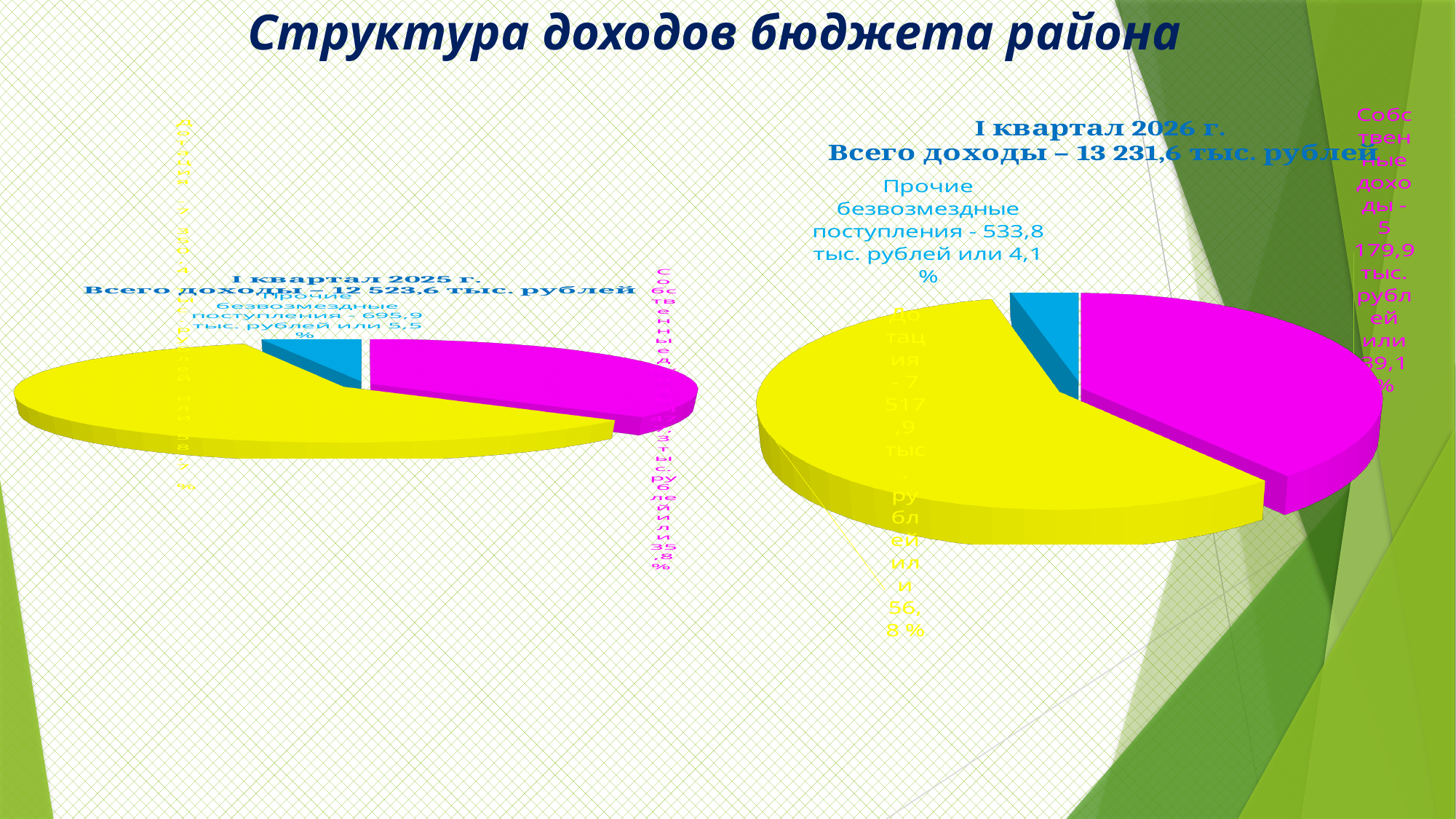
In the 'I квартал 2026 г.' chart, what is the value for Дотация? 7 517,9 тыс. рублей In the 'I квартал 2025 г.' chart, what is the value for Прочие безвозмездные поступления? 695,9 тыс. рублей In the 'I квартал 2026 г.' chart, which category has the largest slice? Дотация In the 'I квартал 2026 г.' chart, how much larger is Дотация than Собственные доходы? 2 338,0 тыс. рублей In the 'I квартал 2026 г.' chart, what is the value for Прочие безвозмездные поступления? 533,8 тыс. рублей How many slices does the 'I квартал 2026 г.' pie chart have? 3 What kind of chart is used for 'I квартал 2026 г.' on the right of the slide? Pie chart Which chart shows the larger value for Прочие безвозмездные поступления, 'I квартал 2025 г.' or 'I квартал 2026 г.'? I квартал 2025 г. In the 'I квартал 2026 г.' chart, which category has the smallest slice? Прочие безвозмездные поступления In the 'I квартал 2026 г.' chart, what share of the pie is Собственные доходы? 39,1 % In the 'I квартал 2026 г.' chart, what share of the pie is Дотация? 56,8 % In the 'I квартал 2026 г.' chart, what is the value for Собственные доходы? 5 179,9 тыс. рублей